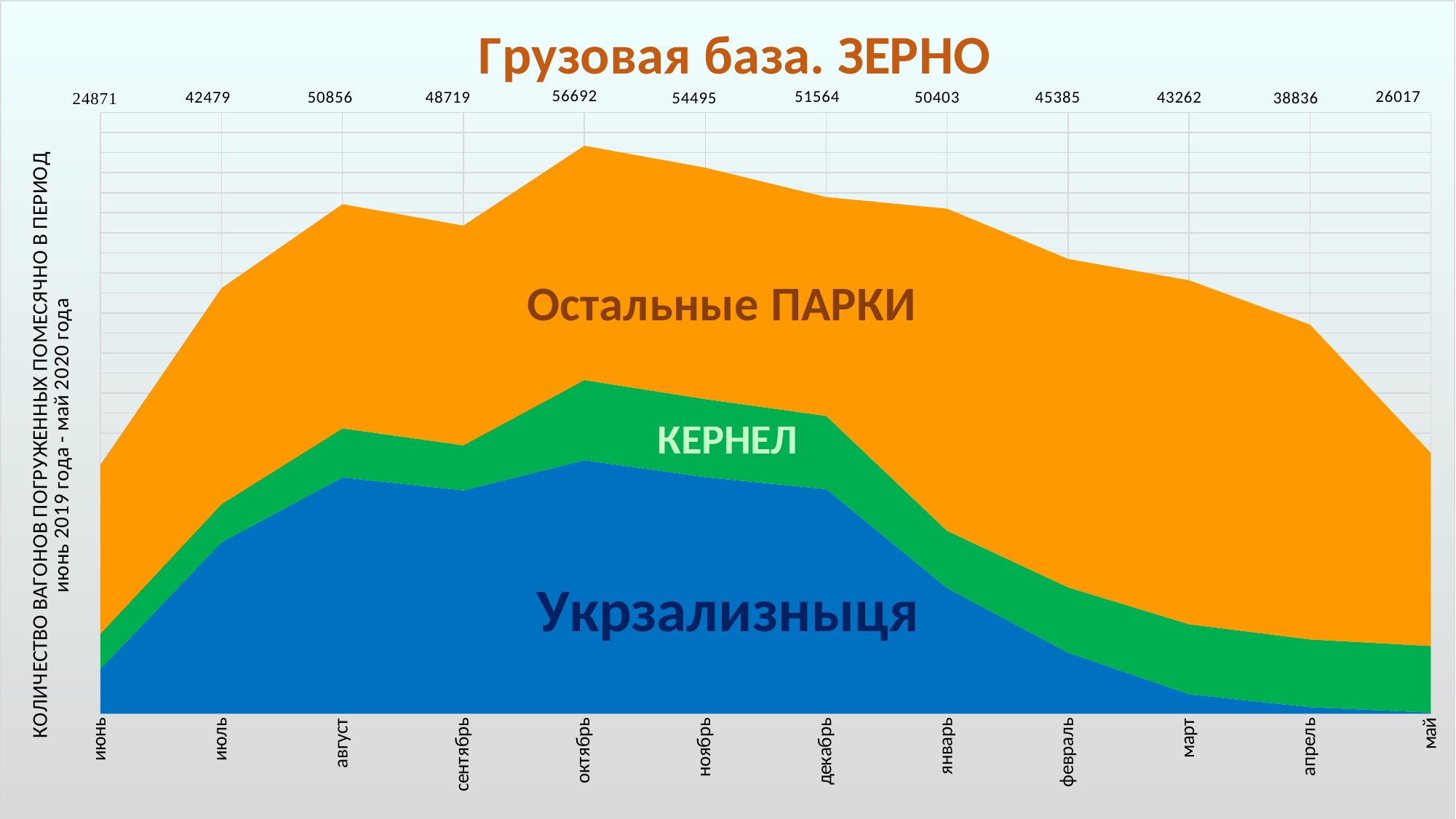
What is the total value shown for октябрь? 56692 Which month has the highest total value? октябрь What is the total value shown for июнь? 24871 What kind of chart is this? stacked area chart Which has a larger total value, август or сентябрь? август What is the title of the chart? Грузовая база. ЗЕРНО What is the difference between the total values for октябрь and май? 30675 How many months are plotted along the x axis? 12 How many series are shown in the chart? 3 Do the total values rise or fall from декабрь to май? fall Which month has the lowest total value? июнь What is the total value shown for февраль? 45385